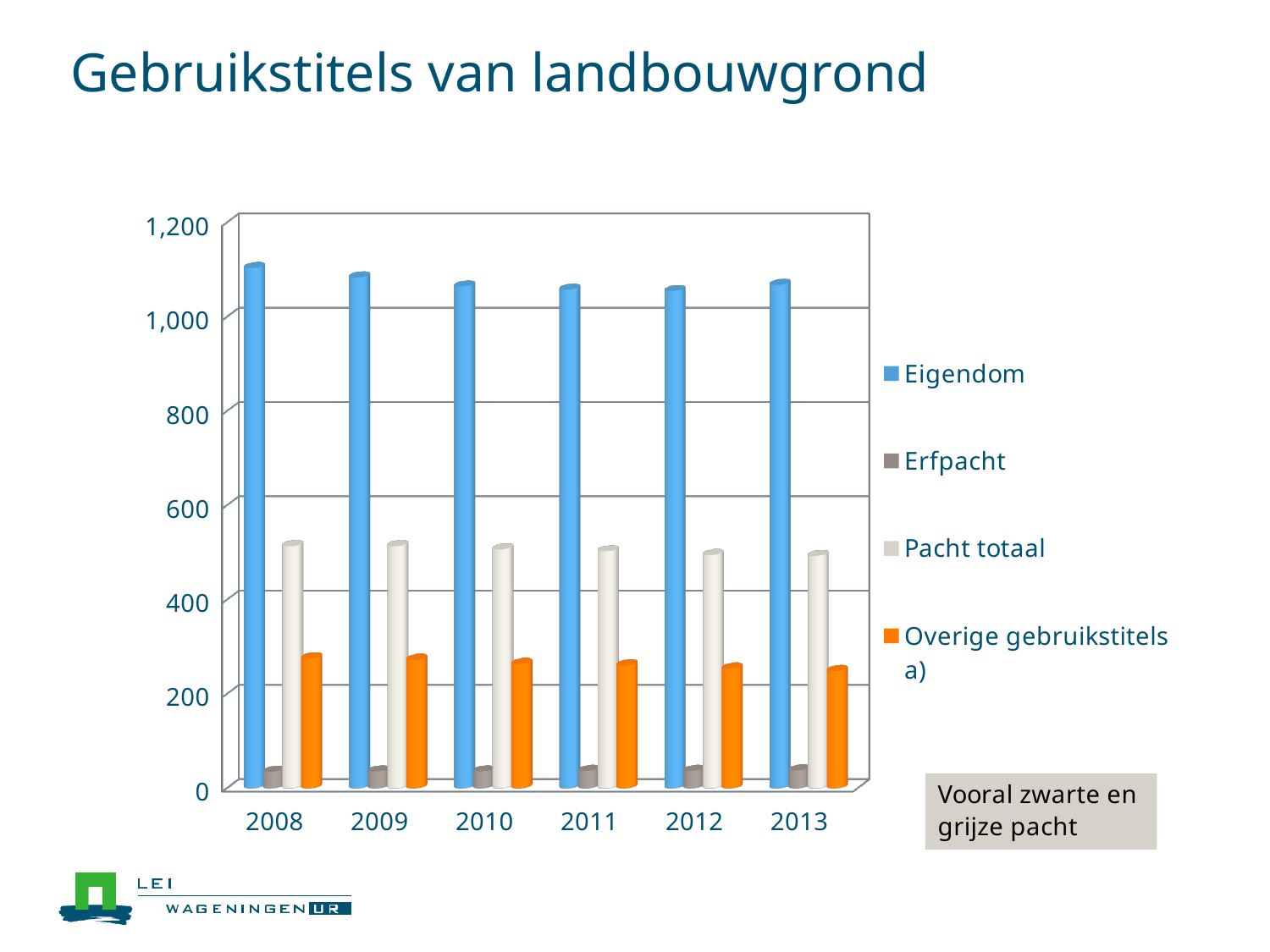
Which series has the lowest values in every year of the chart? Erfpacht Which is larger in 2013: Pacht totaal or Overige gebruikstitels a)? Pacht totaal How many years are shown on the x axis of the chart? 6 How many series does the chart's legend list? 4 What kind of chart is shown on the slide? Bar chart Is the value for Eigendom in 2008 greater or less than 1,000? greater Is the value for Overige gebruikstitels a) in 2009 greater or less than 200? greater Which series has the highest values in every year of the chart? Eigendom In which year is the Eigendom bar the tallest? 2008 Is the value for Pacht totaal in 2011 greater or less than 600? less What is the title of the slide containing the chart? Gebruikstitels van landbouwgrond